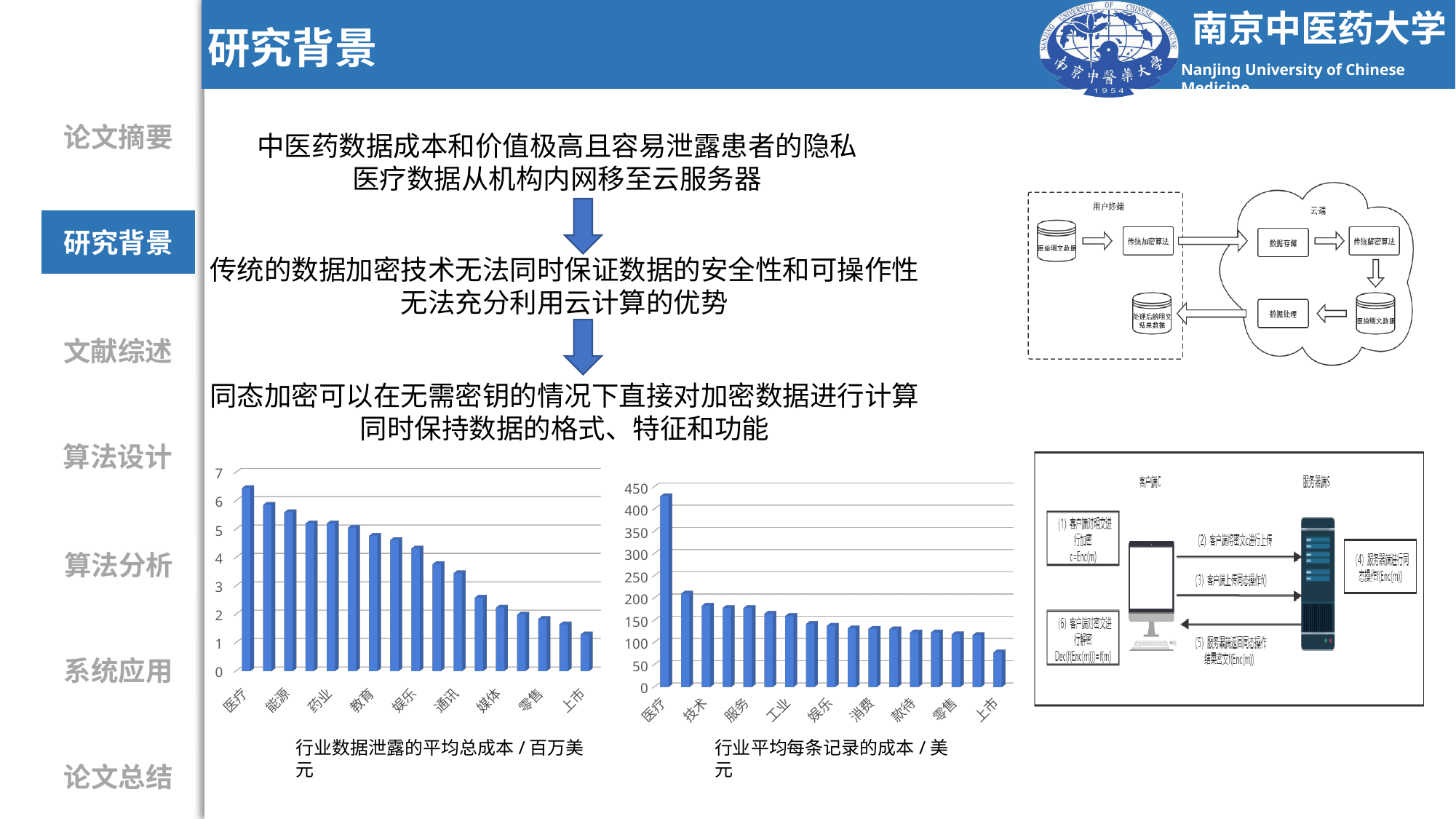
In the left chart (行业数据泄露的平均总成本 / 百万美元), which category has the highest value? 医疗 In the left chart (行业数据泄露的平均总成本 / 百万美元), which labelled category has the lowest value? 上市 In the right chart (行业平均每条记录的成本 / 美元), which labelled category has the lowest value? 上市 In the left chart (行业数据泄露的平均总成本 / 百万美元), is the value for 上市 greater or less than 2? less In the right chart (行业平均每条记录的成本 / 美元), is the value for 上市 greater or less than 100? less In the right chart (行业平均每条记录的成本 / 美元), which is larger, the value for 医疗 or the value for 技术? 医疗 What is the caption under the right chart? 行业平均每条记录的成本 / 美元 In the right chart (行业平均每条记录的成本 / 美元), is the value for 医疗 greater or less than 400? greater In the right chart (行业平均每条记录的成本 / 美元), which category has the highest value? 医疗 In the left chart (行业数据泄露的平均总成本 / 百万美元), do the values rise or fall from left to right along the x axis? fall What kind of chart is the left chart titled 行业数据泄露的平均总成本 / 百万美元? bar chart